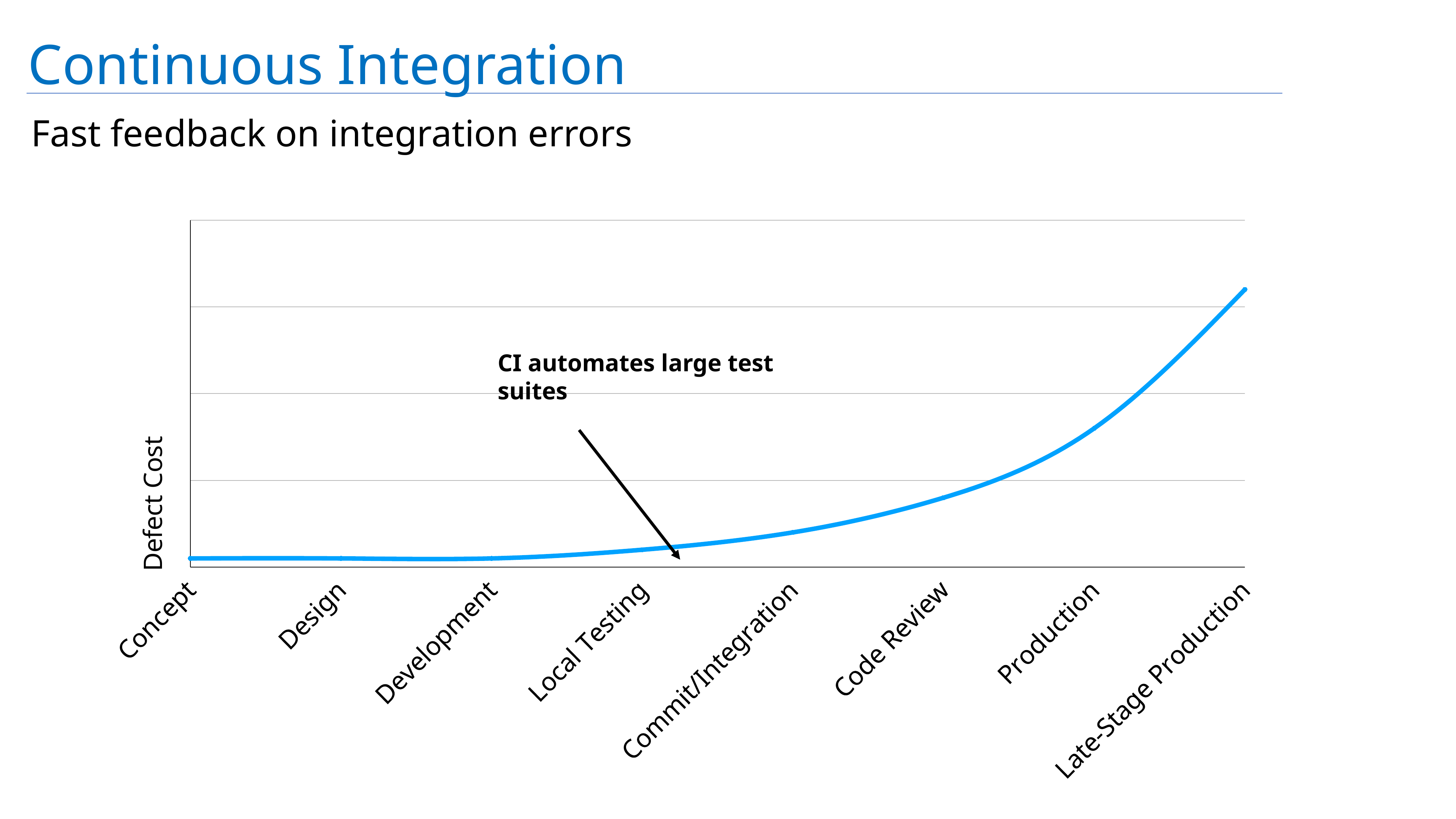
How many categories are shown on the x axis of the chart? 8 What is the first category on the x axis of the chart? Concept Which category has the highest defect cost in the chart? Late-Stage Production What is the label on the vertical axis of the chart? Defect Cost What kind of chart is shown on the slide? Line chart Which has a higher defect cost in the chart, Late-Stage Production or Production? Late-Stage Production Which has a higher defect cost in the chart, Code Review or Local Testing? Code Review Do the values in the chart rise or fall from Concept to Late-Stage Production? Rise Which has a higher defect cost in the chart, Production or Design? Production What does the annotation text on the chart say? CI automates large test suites What is the last category on the x axis of the chart? Late-Stage Production